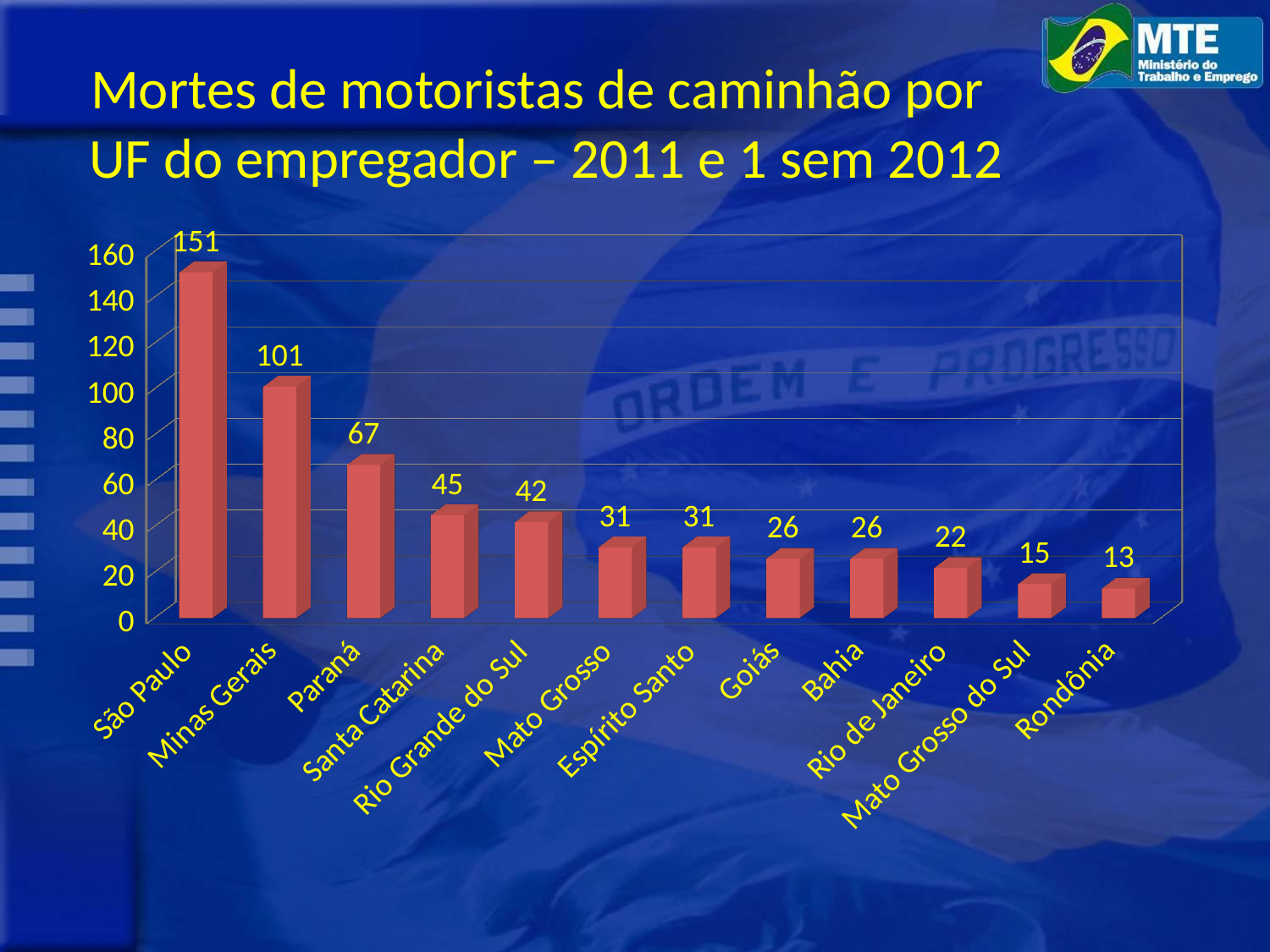
Which is larger, the value for Paraná or the value for Santa Catarina? Paraná What is the value for Rio de Janeiro? 22 What is the value for Paraná? 67 How many states are shown on the chart? 12 What is the value for São Paulo? 151 What is the difference between the values for Santa Catarina and Rio Grande do Sul? 3 Which state has the lowest value? Rondônia What kind of chart is shown on the slide? bar chart What is the difference between the values for São Paulo and Minas Gerais? 50 Which state has the highest value? São Paulo Is the value for Minas Gerais greater or less than 100? greater Do the values rise or fall from left to right along the x axis? fall